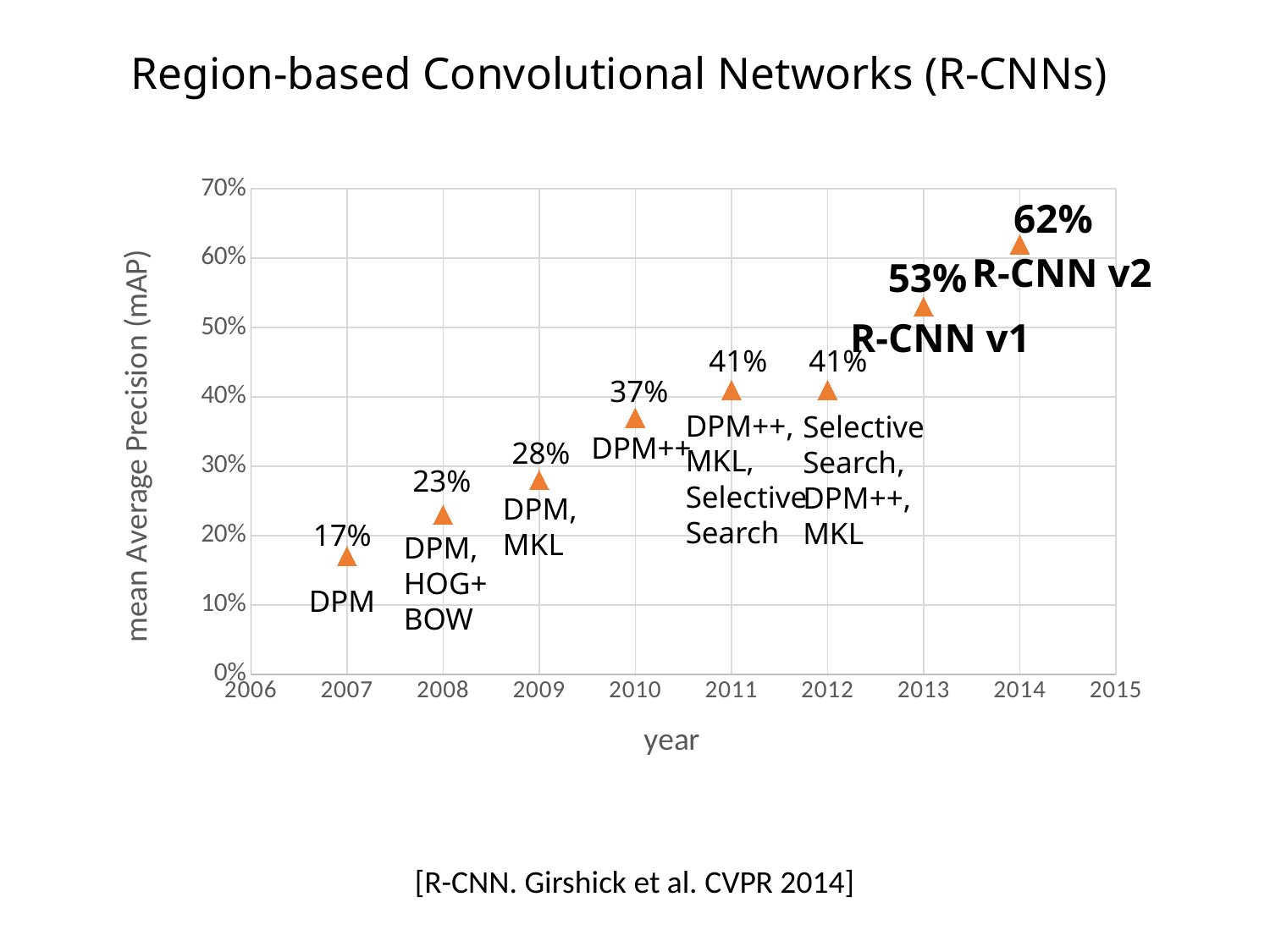
What is the difference in mAP between 2009 and 2008? 5% What is the label of the y axis? mean Average Precision (mAP) Which year has the lowest mAP value? 2007 Which year has the highest mAP value? 2014 Do the mAP values generally rise or fall as the year increases? rise What is the mAP value plotted for 2013 (R-CNN v1)? 53% How many data points are plotted on the chart? 8 What is the mAP value plotted for 2014 (R-CNN v2)? 62% Which has a higher mAP, 2012 or 2013? 2013 What is the mAP value plotted for 2010? 37% What is the mean Average Precision (mAP) value plotted for 2007? 17% What is the difference in mAP between 2014 and 2013? 9%